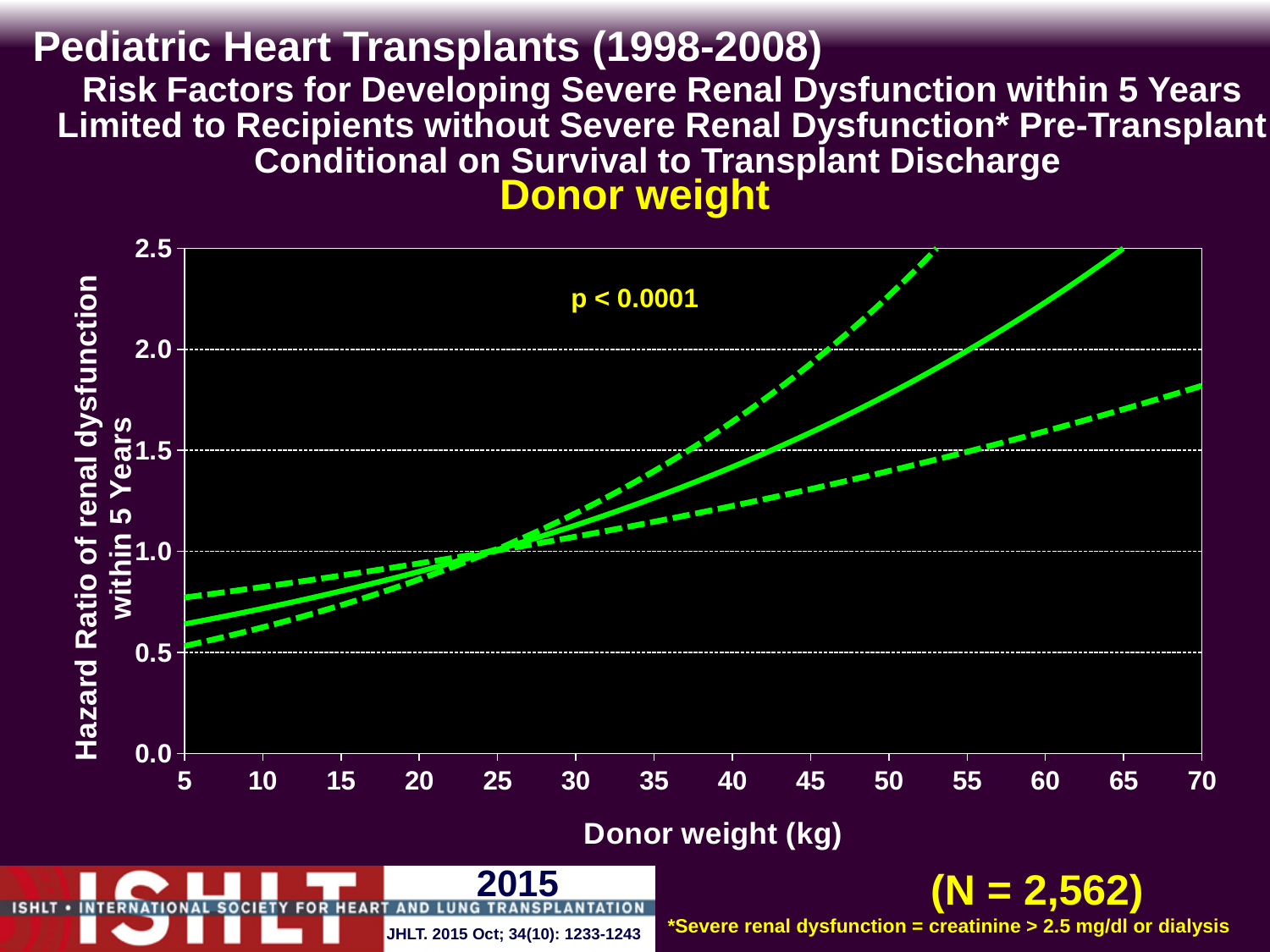
Is the value of the lower dashed line at a donor weight of 70 kg greater or less than 1.5? greater Is the value of the upper dashed line at a donor weight of 50 kg greater or less than 2.0? greater How many lines are plotted on the chart? 3 Is the value of the upper dashed line at a donor weight of 5 kg greater or less than 1.0? less Does the hazard ratio (solid line) rise or fall as donor weight increases from 5 kg to 70 kg? rise What p-value is shown on the chart? p < 0.0001 What kind of chart is shown on the slide? line chart What is the sample size (N) shown on the slide? N = 2,562